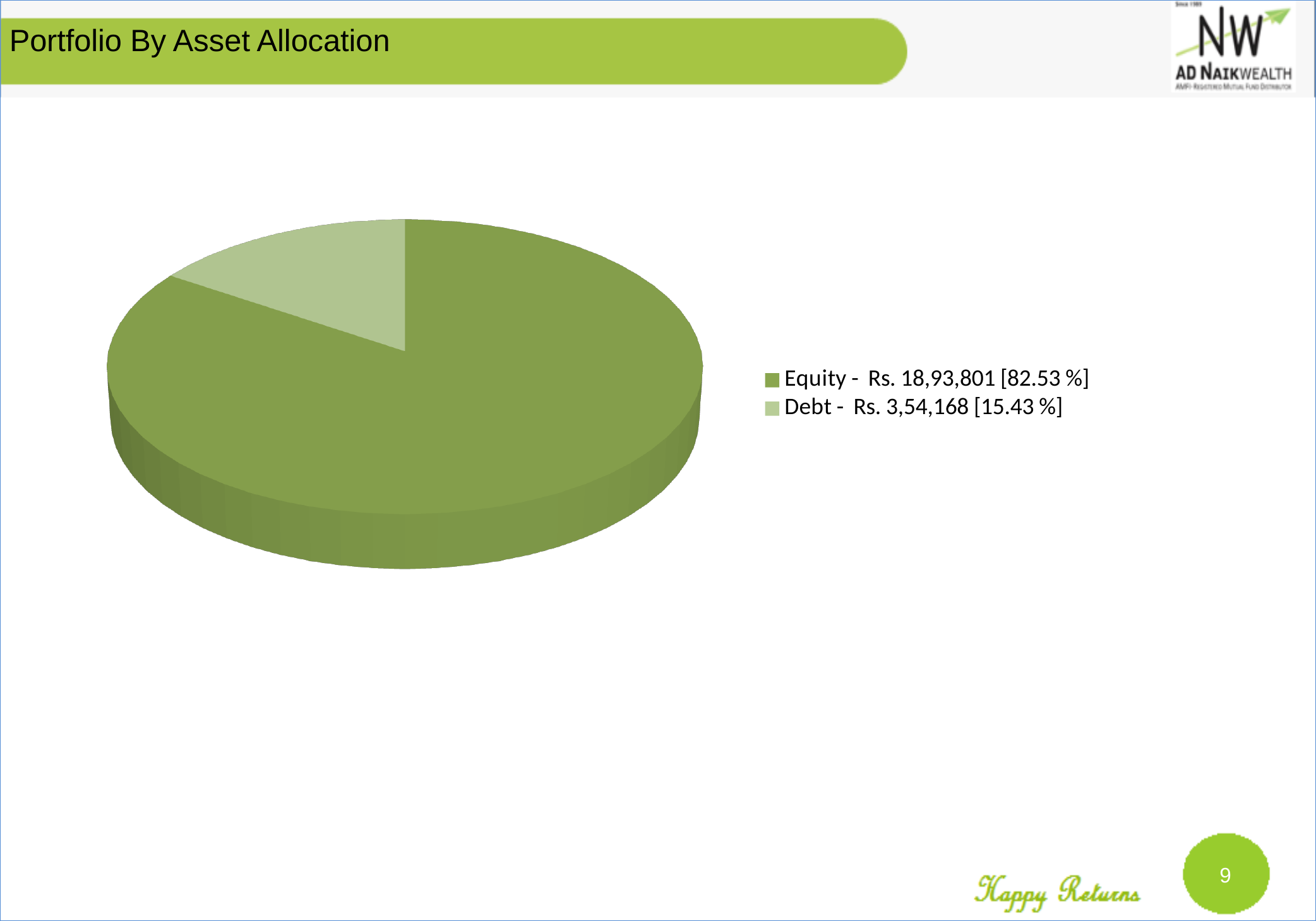
How many categories does the legend of the pie chart list? 2 What percentage share does Debt have in the pie chart? 15.43 % What is the value for Debt in the pie chart? Rs. 3,54,168 What is the title of the slide containing the pie chart? Portfolio By Asset Allocation What is the difference between the Equity value and the Debt value? Rs. 15,39,633 Which category has the smallest slice in the pie chart? Debt Which category has the largest slice in the pie chart? Equity What percentage share does Equity have in the pie chart? 82.53 % Which is larger, the value for Equity or the value for Debt? Equity What type of chart is shown on the slide? Pie chart What is the value for Equity in the pie chart? Rs. 18,93,801 By how many percentage points does Equity's share exceed Debt's share? 67.10 %